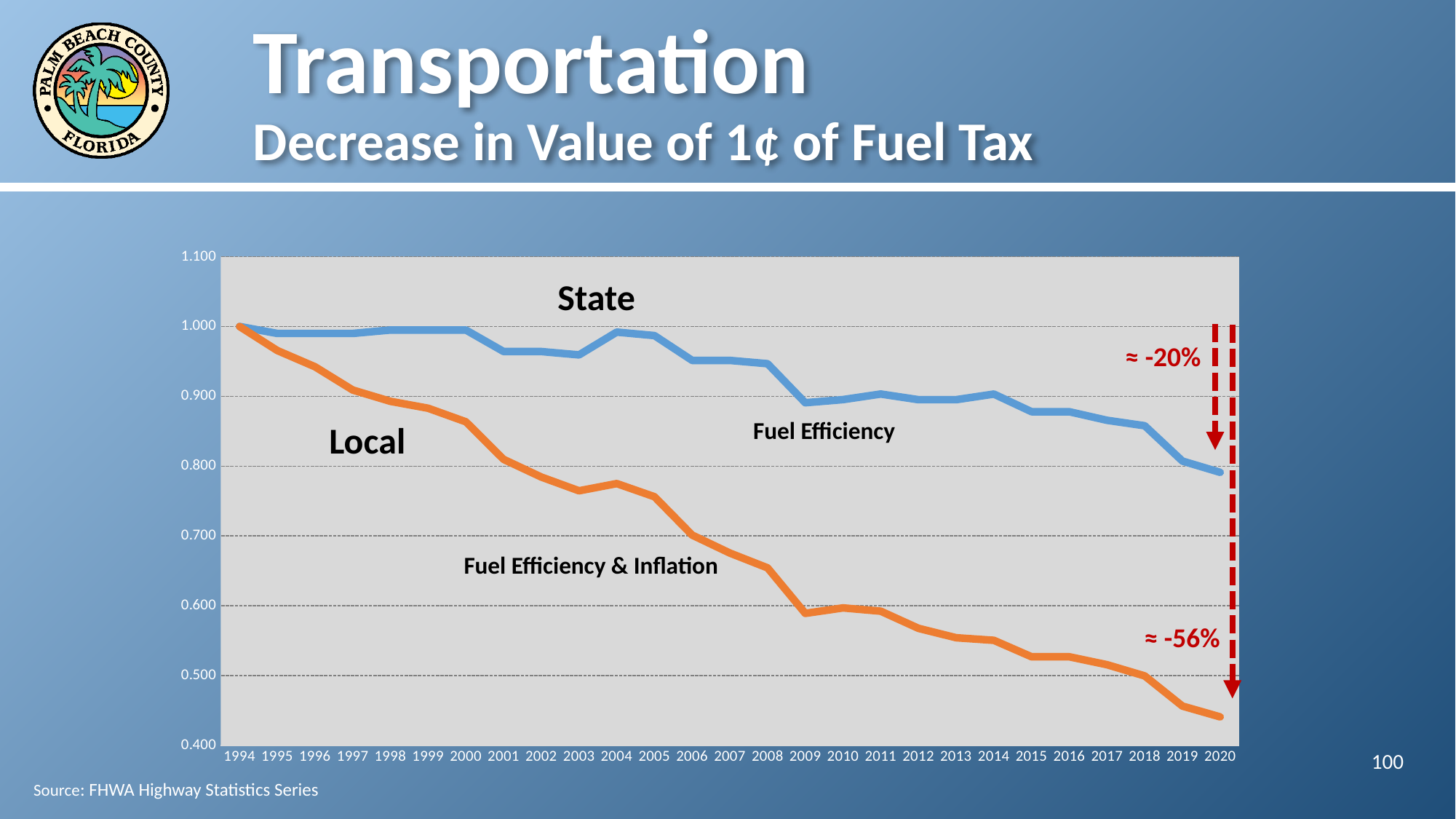
In 2010, which line has the higher value, State or Local? State What is the value of the Local line in 1994? 1.000 How many years are shown along the x axis of the chart? 27 How many lines (series) are plotted on the chart? 2 What approximate percentage decrease is annotated for the Local line? ≈ -56% Is the value of the State line in 2006 greater or less than 0.900? greater What is the value of the State line in 1994? 1.000 What kind of chart is shown on the slide? line chart Is the value of the State line in 2015 greater or less than 0.900? less Do the values of the Local line rise or fall from 1994 to 2020? fall Is the value of the Local line in 2000 greater or less than 0.800? greater